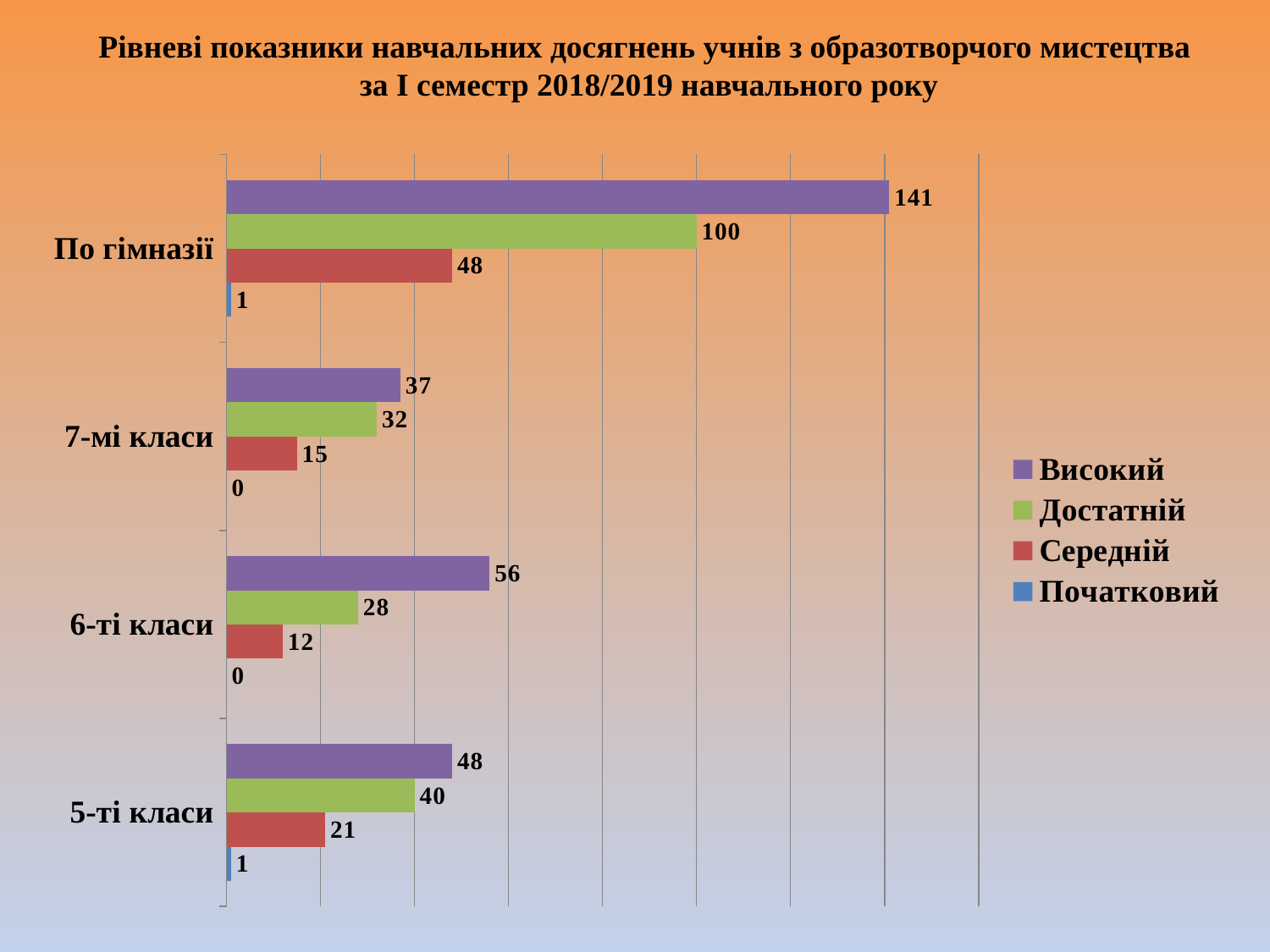
What is the value for Достатній in the 7-мі класи category? 32 How many categories are shown on the chart? 4 What is the value for Середній in the 5-ті класи category? 21 What is the difference between the Високий and Достатній values in the По гімназії category? 41 Which series is shown in green in the legend? Достатній What is the value for Початковий in the 6-ті класи category? 0 How many series does the legend list? 4 Which is larger: the Високий value for 6-ті класи or the Високий value for 5-ті класи? 6-ті класи Among the class categories (5-ті, 6-ті, 7-мі класи), which has the lowest value for Середній? 6-ті класи What type of chart is shown on the slide? bar chart Which category has the highest value for Високий? По гімназії What is the value for Високий in the По гімназії category? 141